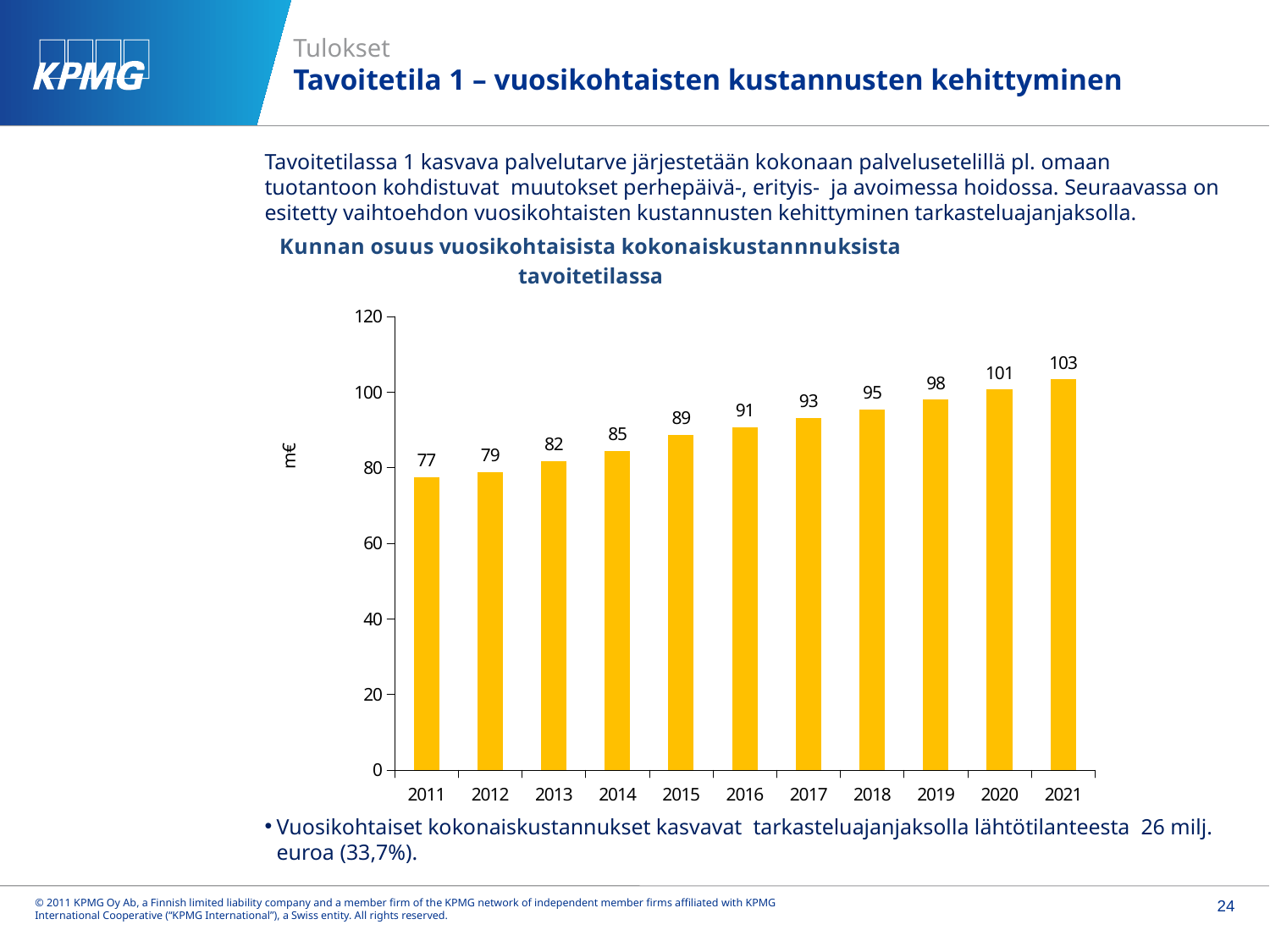
What unit is shown on the y axis label? m€ What is the value for 2016? 91 What is the value for 2021? 103 How many years are shown on the x axis? 11 Do the values rise or fall from 2011 to 2021? rise Which is larger, the value for 2014 or the value for 2018? 2018 What kind of chart is shown? bar chart What is the difference between the values for 2021 and 2011? 26 Is the value for 2020 greater or less than 100? greater Which year has the highest value? 2021 What is the value for 2011? 77 Which year has the lowest value? 2011